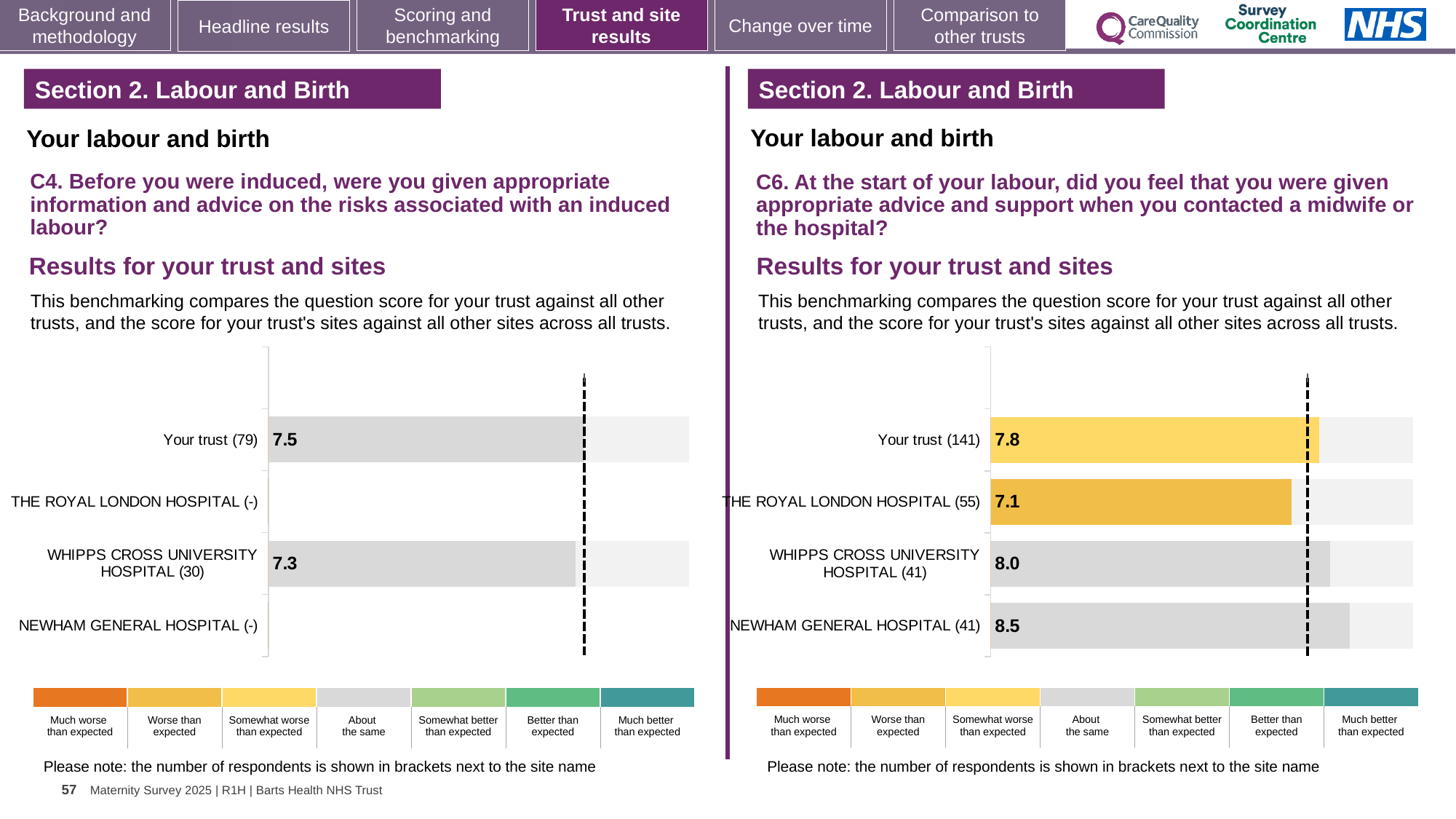
In the C6 chart on the right, which has the larger score: WHIPPS CROSS UNIVERSITY HOSPITAL (41) or Your trust (141)? WHIPPS CROSS UNIVERSITY HOSPITAL (41) In the C6 chart on the right, what is the score for THE ROYAL LONDON HOSPITAL (55)? 7.1 In the C4 chart on the left, what is the difference between the scores for Your trust (79) and WHIPPS CROSS UNIVERSITY HOSPITAL (30)? 0.2 In the C4 chart on the left, how many site or trust categories are listed on the vertical axis? 4 In the C4 chart on the left, what is the score for Your trust (79)? 7.5 In the C6 chart on the right, which site has the highest score? NEWHAM GENERAL HOSPITAL (41) In the C6 chart on the right, what is the score for NEWHAM GENERAL HOSPITAL (41)? 8.5 In the C6 chart on the right, what is the score for Your trust (141)? 7.8 What type of chart is used in the C6 chart on the right? Bar chart In the C6 chart on the right, which site has the lowest score? THE ROYAL LONDON HOSPITAL (55) In the C4 chart on the left, what is the score for WHIPPS CROSS UNIVERSITY HOSPITAL (30)? 7.3 In the C6 chart on the right, what is the difference between the scores for NEWHAM GENERAL HOSPITAL (41) and THE ROYAL LONDON HOSPITAL (55)? 1.4